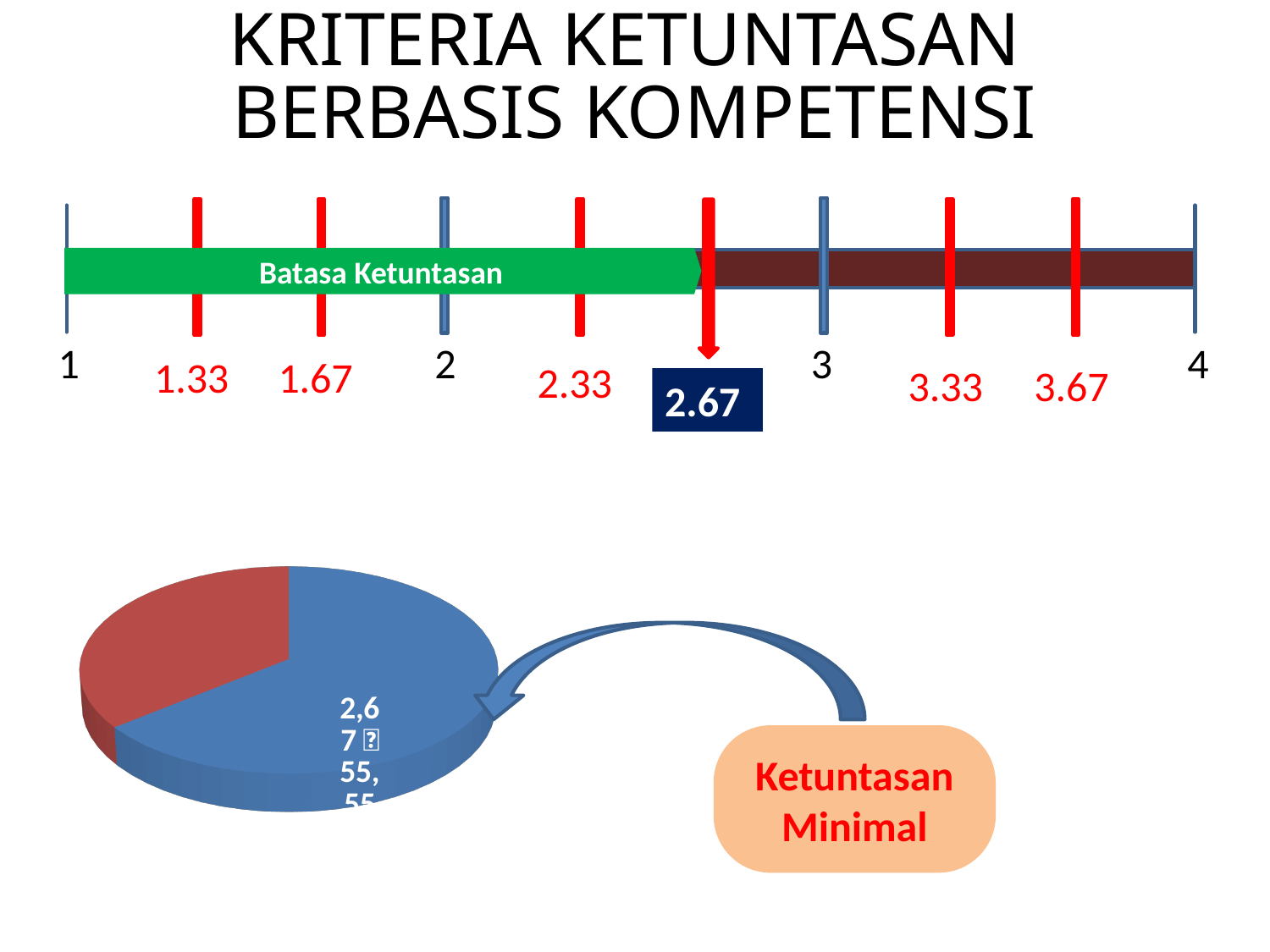
Which slice of the pie chart is larger, the blue one or the red one? blue How many slices does the pie chart have? 2 What two colours are used for the slices of the pie chart? blue and red Which slice of the pie chart is the smallest? the red slice Does the pie chart display a legend? No Which slice of the pie chart is the largest? the blue slice What kind of chart is shown at the bottom of the slide? pie chart